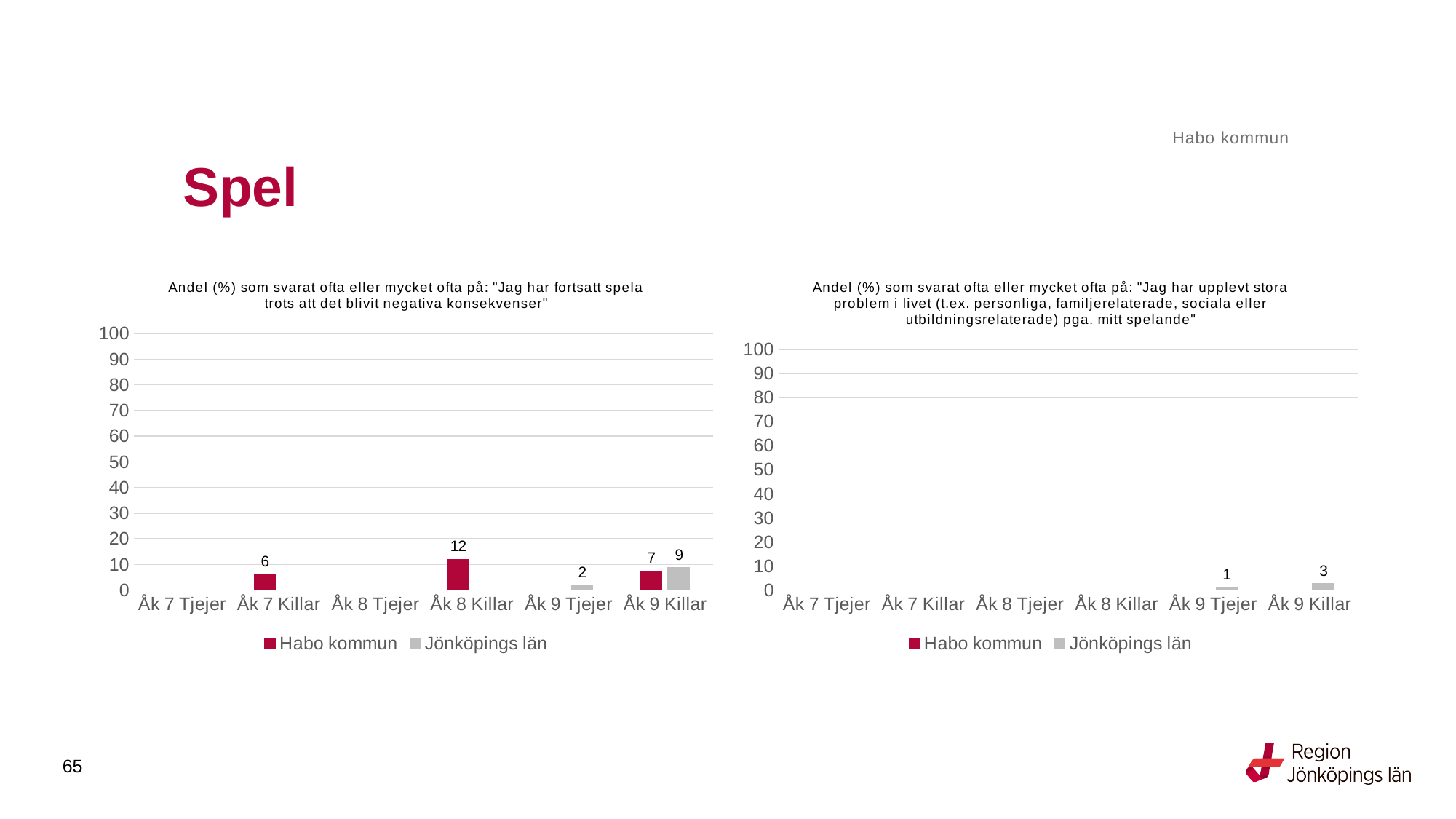
In the left chart, what is the value for Jönköpings län for Åk 9 Killar? 9 In the left chart, what is the value for Habo kommun for Åk 8 Killar? 12 In the left chart, which category has the highest Habo kommun value? Åk 8 Killar In the left chart, for Åk 9 Killar, which is larger: Habo kommun or Jönköpings län? Jönköpings län In the left chart, what is the value for Jönköpings län for Åk 9 Tjejer? 2 In the right chart, what is the value for Jönköpings län for Åk 9 Killar? 3 In the right chart, what is the value for Jönköpings län for Åk 9 Tjejer? 1 How many categories are shown on the x axis of the right chart? 6 In the left chart, what is the value for Habo kommun for Åk 7 Killar? 6 What kind of chart is the left chart? Bar chart In the left chart, what is the difference between the Jönköpings län and Habo kommun values for Åk 9 Killar? 2 How many series does the legend of the left chart list? 2